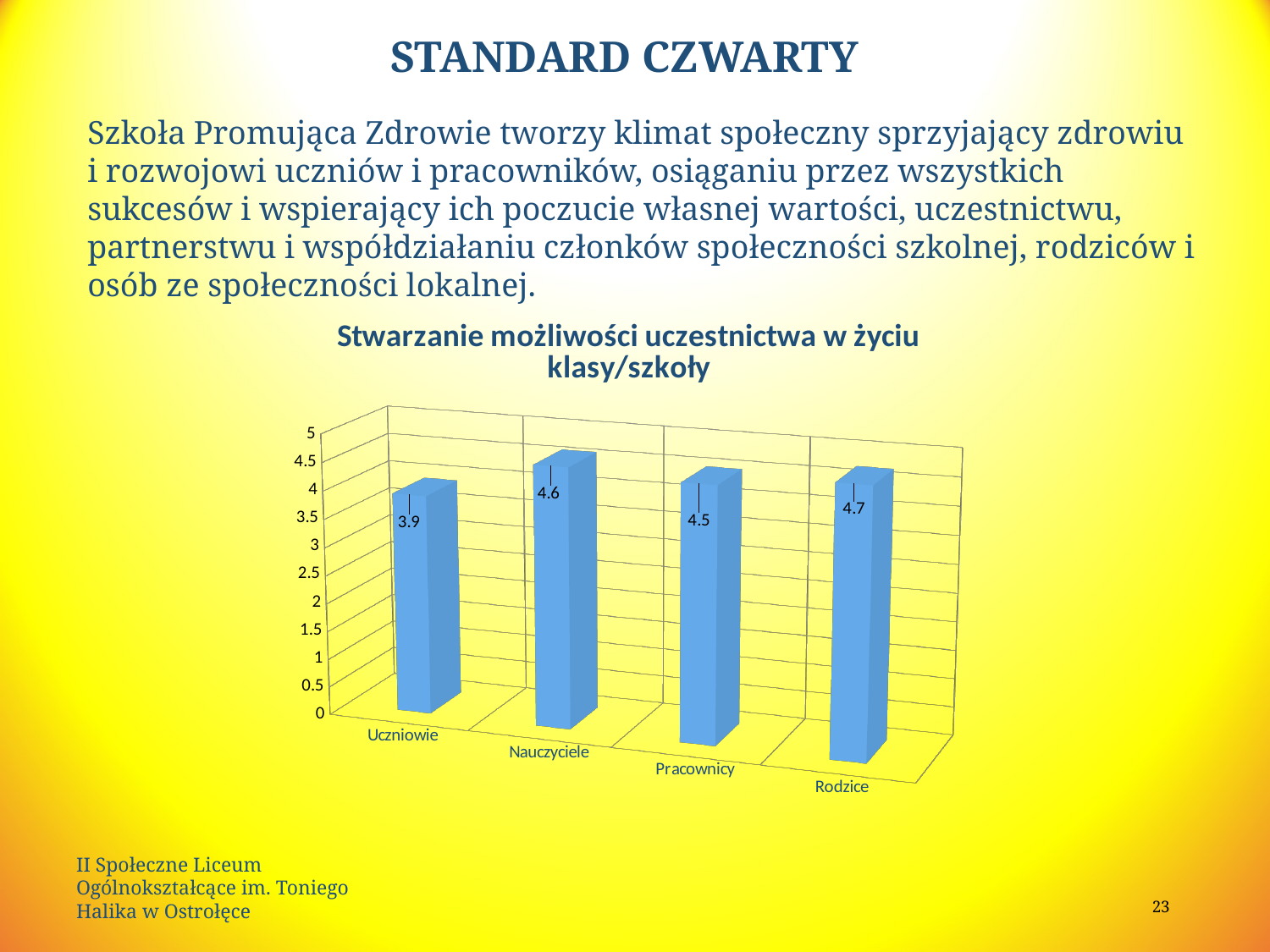
Which category has the highest value? Rodzice What is the value for Uczniowie? 3.9 Which category has the lowest value? Uczniowie How many categories are shown on the chart? 4 Which is larger, the value for Nauczyciele or the value for Uczniowie? Nauczyciele Is the value for Uczniowie greater or less than 4? less What kind of chart is shown on the slide? bar chart What is the value for Pracownicy? 4.5 What is the difference between the values for Rodzice and Uczniowie? 0.8 What is the value for Rodzice? 4.7 What is the title of the chart? Stwarzanie możliwości uczestnictwa w życiu klasy/szkoły What is the value for Nauczyciele? 4.6